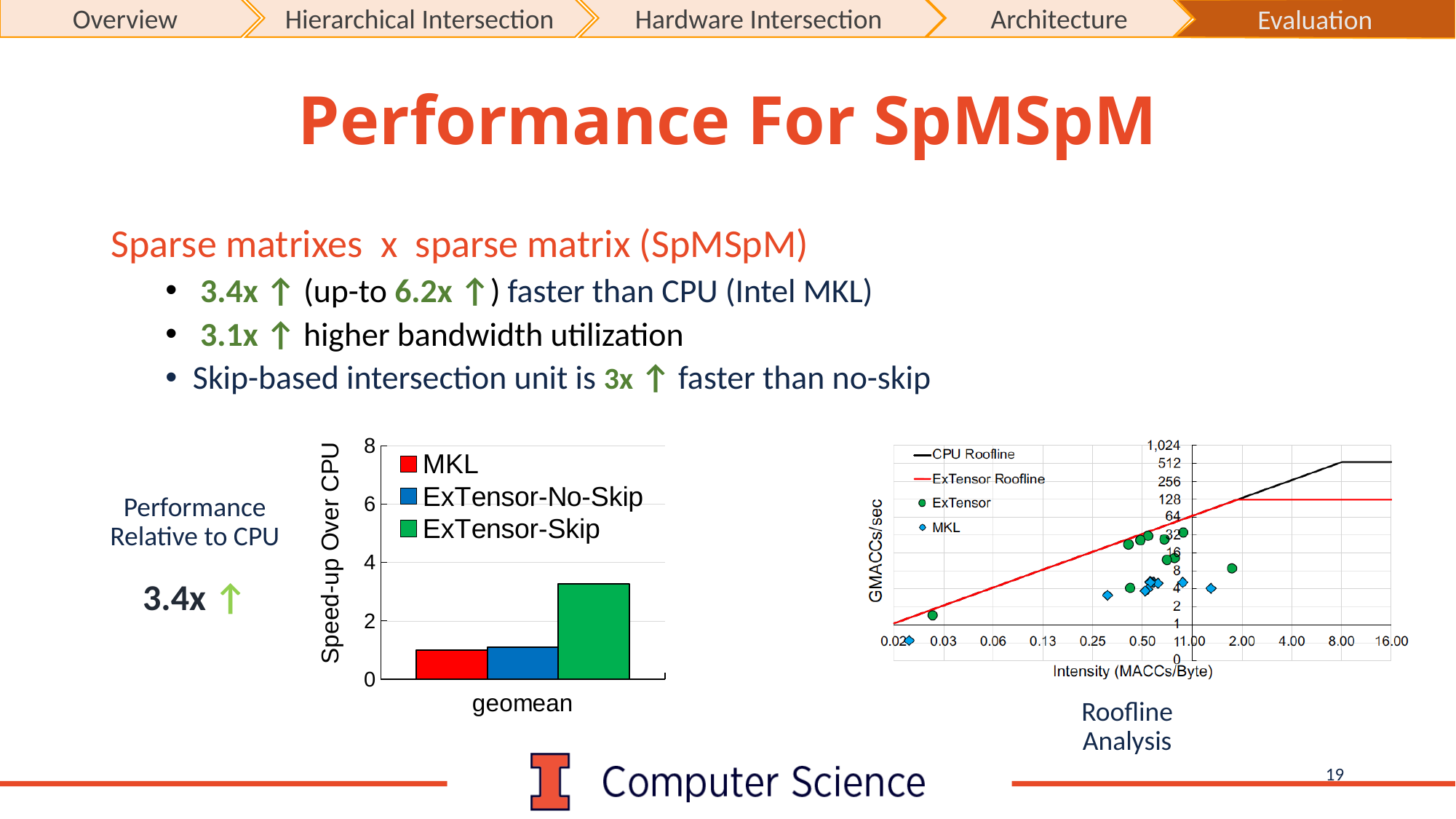
In the bar chart on the left, is the speed-up for MKL greater or less than 2? less In the bar chart on the left, which series has the highest speed-up over CPU for geomean? ExTensor-Skip What is the y-axis label of the bar chart on the left? Speed-up Over CPU How many categories are shown on the x axis of the bar chart on the left? 1 In the bar chart on the left, is the speed-up for ExTensor-No-Skip greater or less than 2? less In the bar chart on the left, is the speed-up for ExTensor-Skip greater or less than 4? less In the bar chart on the left, which is larger: the speed-up for ExTensor-Skip or for MKL? ExTensor-Skip What kind of chart is the chart on the left of the slide? bar chart How many entries does the legend of the Roofline Analysis chart on the right list? 4 What is the x-axis label of the Roofline Analysis chart on the right? Intensity (MACCs/Byte) How many series does the legend of the bar chart on the left list? 3